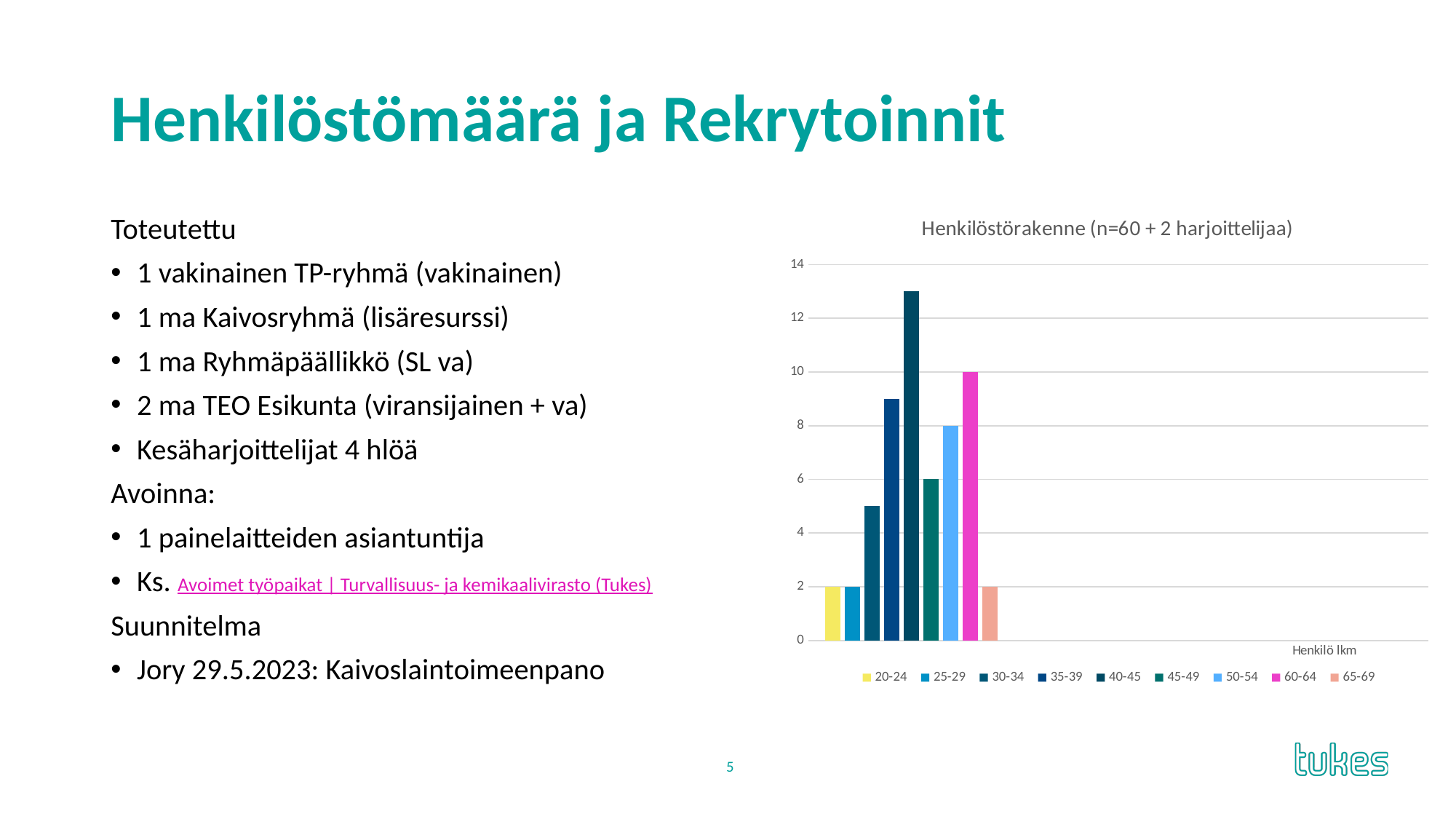
What is the value for the 45-49 age group? 6 What is the value for the 50-54 age group? 8 Is the value for the 40-45 age group greater or less than 12? greater Which age group has the highest value in the chart? 40-45 What is the title of the chart? Henkilöstörakenne (n=60 + 2 harjoittelijaa) What is the value for the 65-69 age group? 2 What is the value for the 60-64 age group? 10 What is the difference between the values for 60-64 and 50-54? 2 Which is larger, the value for 60-64 or the value for 50-54? 60-64 Is the value for the 35-39 age group greater or less than 8? greater What type of chart is shown on the slide? bar chart How many series does the chart legend list? 9